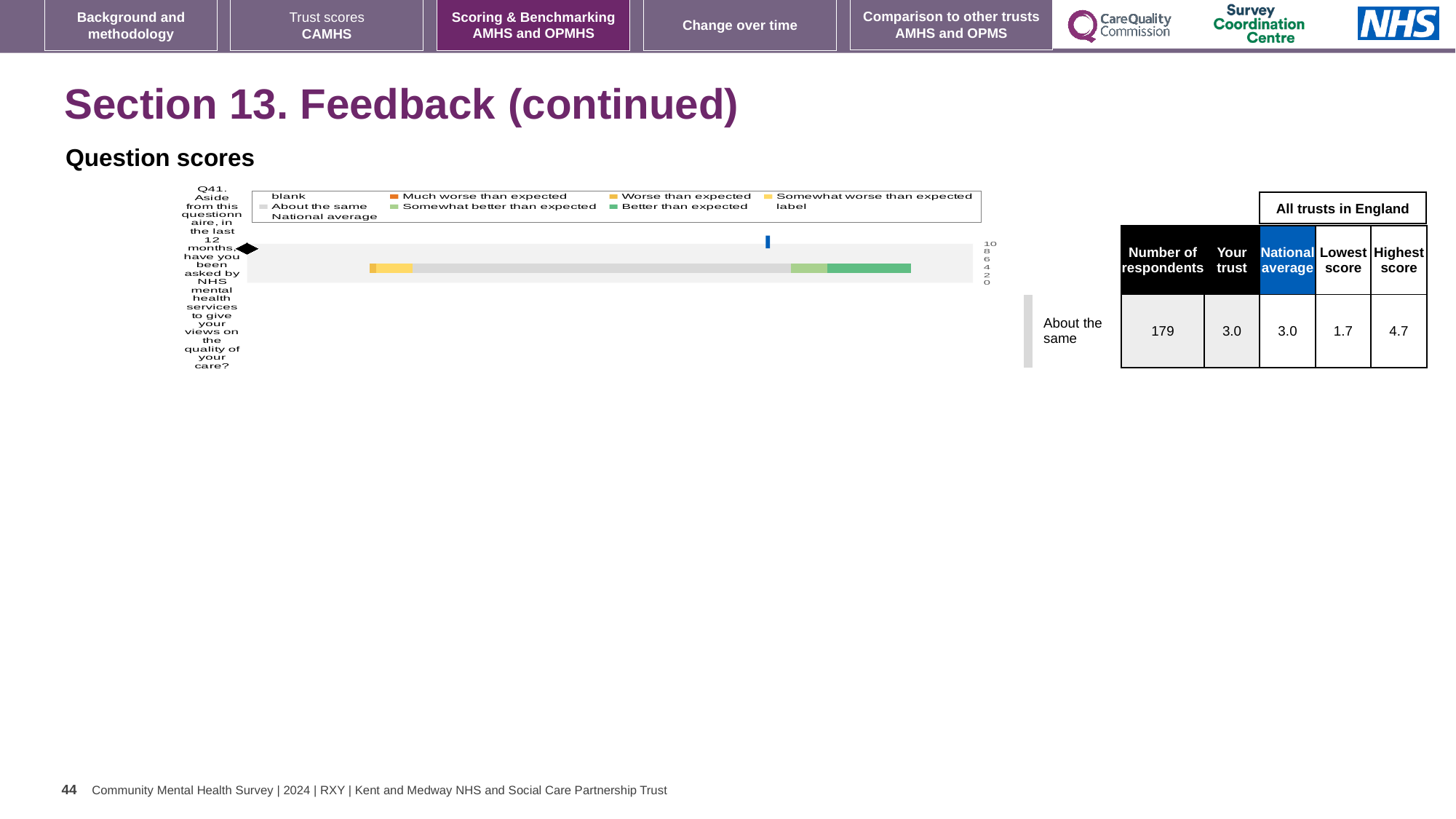
In the table to the right of the chart, what is the 'Your trust' score for Q41? 3.0 What is the difference between the highest score and the lowest score for Q41 in the table? 3.0 In the table to the right of the chart, what is the national average score for Q41? 3.0 What kind of chart is shown under 'Question scores'? bar chart Which question number is plotted in the bar chart? Q41 In the table to the right of the chart, what is the highest score among all trusts in England for Q41? 4.7 In the table to the right of the chart, what is the lowest score among all trusts in England for Q41? 1.7 Is the 'Your trust' score for Q41 larger than, smaller than, or equal to the national average? equal How many question categories are plotted in the bar chart? 1 In the table to the right of the chart, what is the number of respondents for Q41? 179 What benchmark category label is shown next to the Q41 bar? About the same What is the maximum value shown on the chart's axis? 10